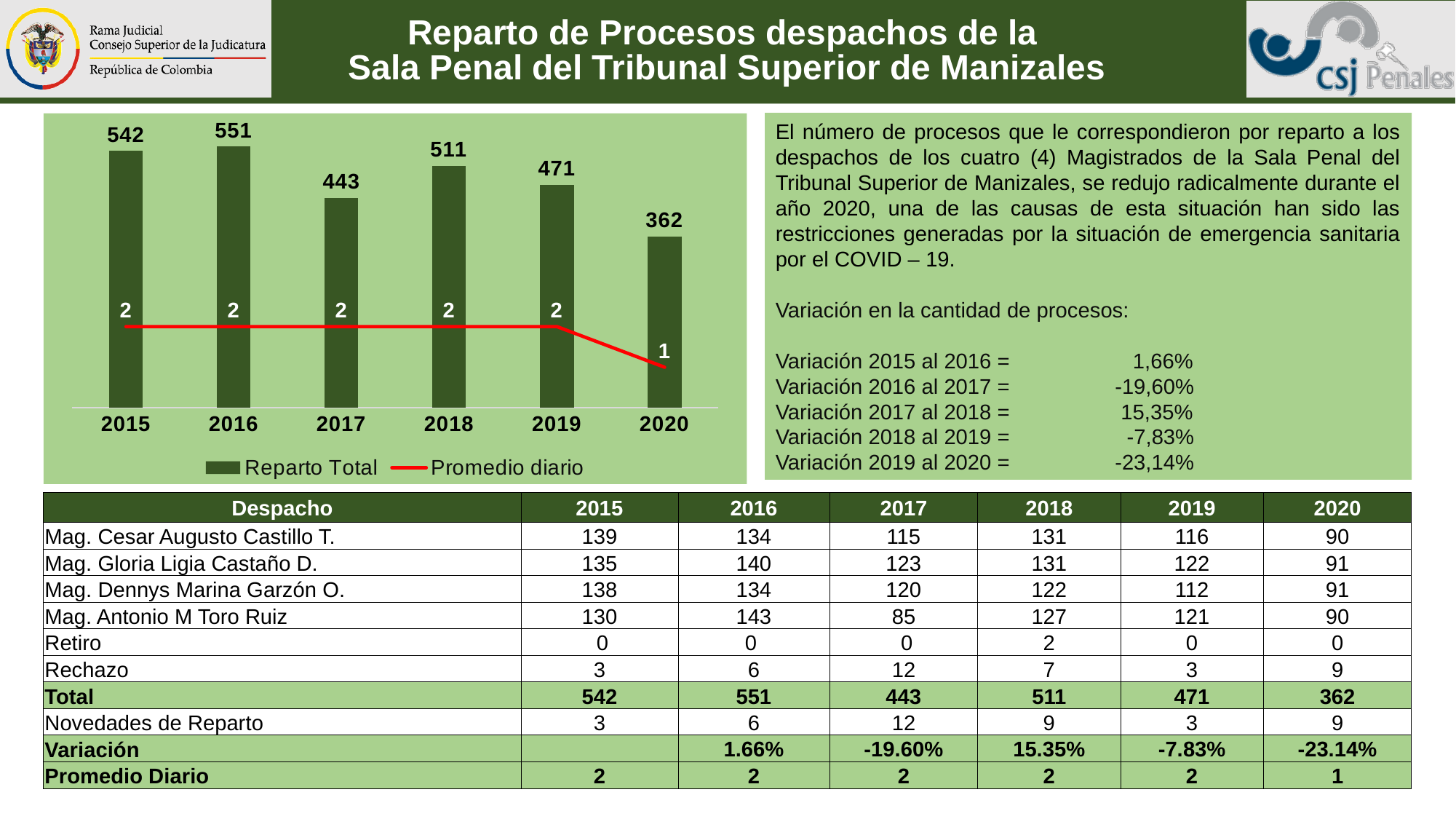
What is the difference between the Reparto Total for 2016 and 2017? 108 Which is larger, the Reparto Total for 2015 or for 2019? 2015 How many years are shown on the x axis of the chart? 6 Which year has the lowest Reparto Total? 2020 What kind of chart is used to show Reparto Total? Bar chart Which year has the highest Reparto Total? 2016 How many series does the chart legend list? 2 What colour is the Promedio diario line in the chart? Red What is the Reparto Total value for 2020? 362 What is the Reparto Total value for 2018? 511 Does the Reparto Total rise or fall from 2018 to 2020? Fall What is the Promedio diario value for 2020? 1